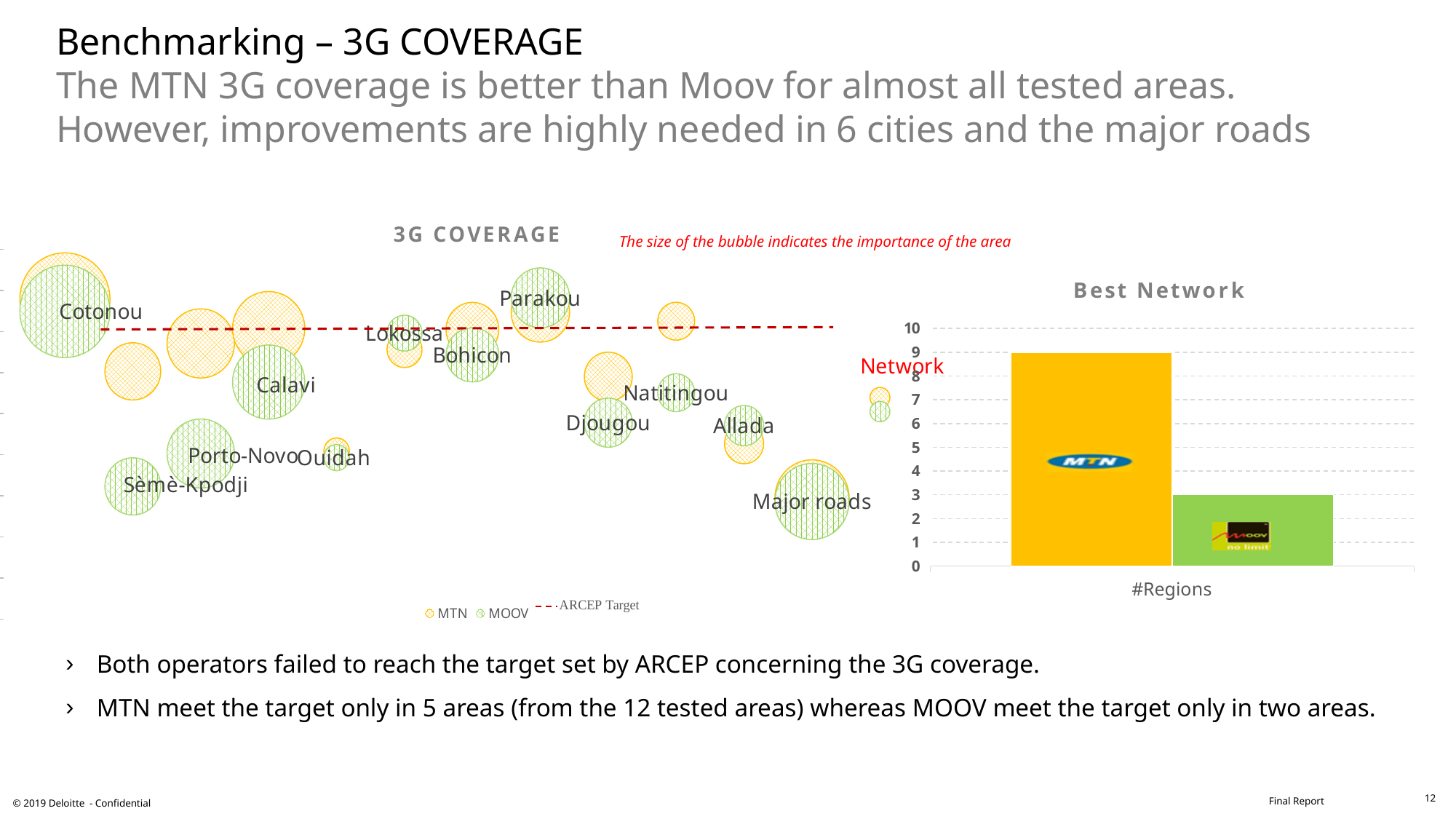
In the Best Network chart, which operator has the higher bar? MTN In the Best Network chart, what is the value of the MTN bar? 9 In the Best Network chart, which operator has the lower bar? MOOV In the 3G COVERAGE chart, what does the size of a bubble indicate? The importance of the area In the Best Network chart, what is the difference between the MTN and MOOV bars? 6 In the 3G COVERAGE chart, how many tested areas are labelled? 12 In the Best Network chart, what kind of chart is used? Bar chart In the 3G COVERAGE chart, what kind of chart is used? Bubble chart In the Best Network chart, what is the value of the MOOV bar? 3 In the 3G COVERAGE chart, what does the red dashed line represent? ARCEP Target In the Best Network chart, how many bars are plotted? 2 In the Best Network chart, is the value for MOOV greater or less than 5? less